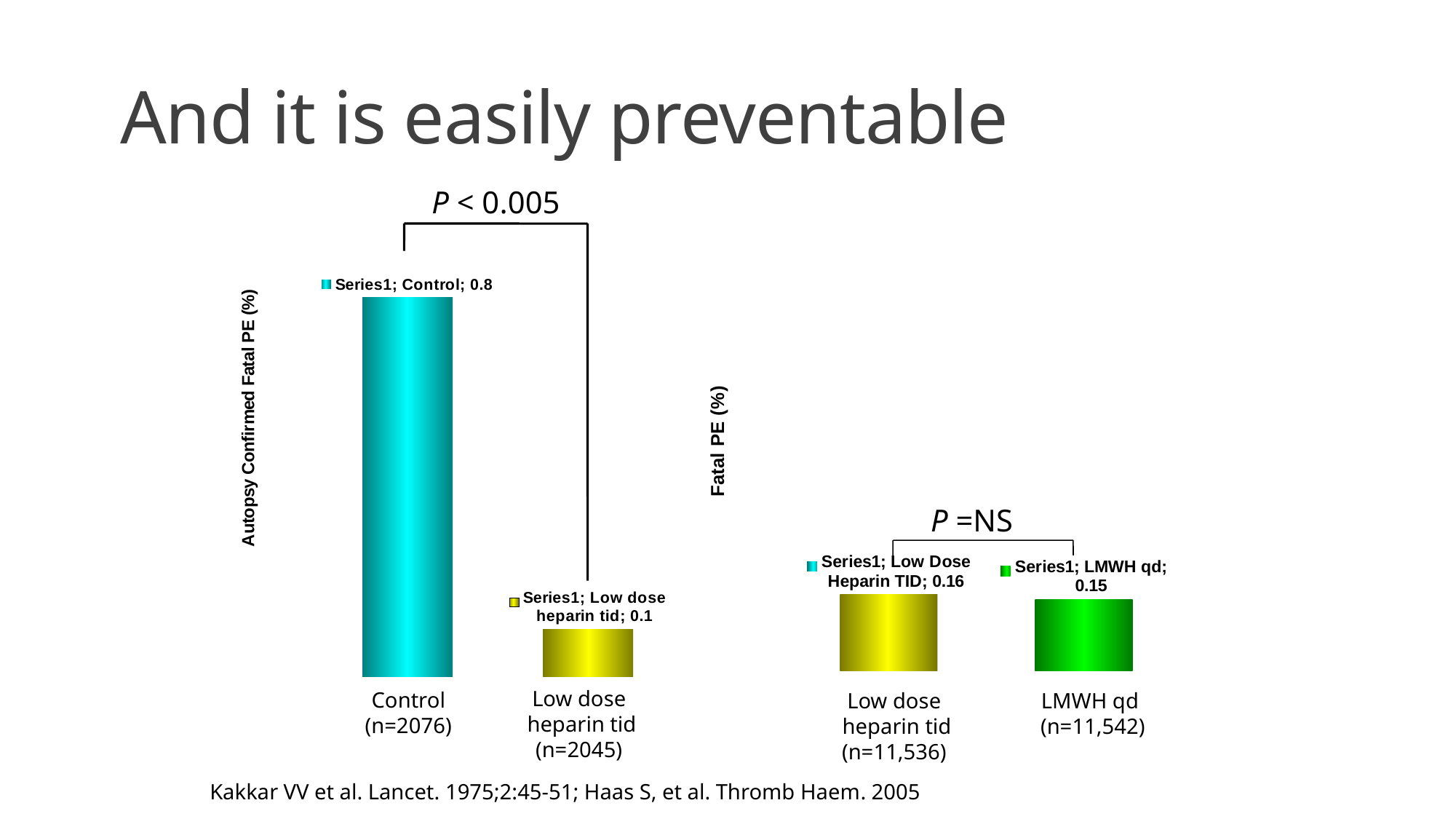
In the left chart (Autopsy Confirmed Fatal PE), which is larger: the value for Control or the value for Low dose heparin tid? Control In the left chart (Autopsy Confirmed Fatal PE), what is the value for Low dose heparin tid? 0.1 In the right chart (Fatal PE), what is the value for Low Dose Heparin TID? 0.16 What kind of chart is the left chart (Autopsy Confirmed Fatal PE)? Bar chart In the left chart (Autopsy Confirmed Fatal PE), which category has the lowest value? Low dose heparin tid In the left chart (Autopsy Confirmed Fatal PE), what is the difference between the Control value and the Low dose heparin tid value? 0.7 In the right chart (Fatal PE), what is the difference between the Low Dose Heparin TID value and the LMWH qd value? 0.01 In the right chart (Fatal PE), what is the value for LMWH qd? 0.15 How many categories are plotted in the right chart (Fatal PE)? 2 In the left chart (Autopsy Confirmed Fatal PE), what is the value for Control? 0.8 What is the y-axis title of the right chart? Fatal PE (%) In the left chart (Autopsy Confirmed Fatal PE), which category has the highest value? Control